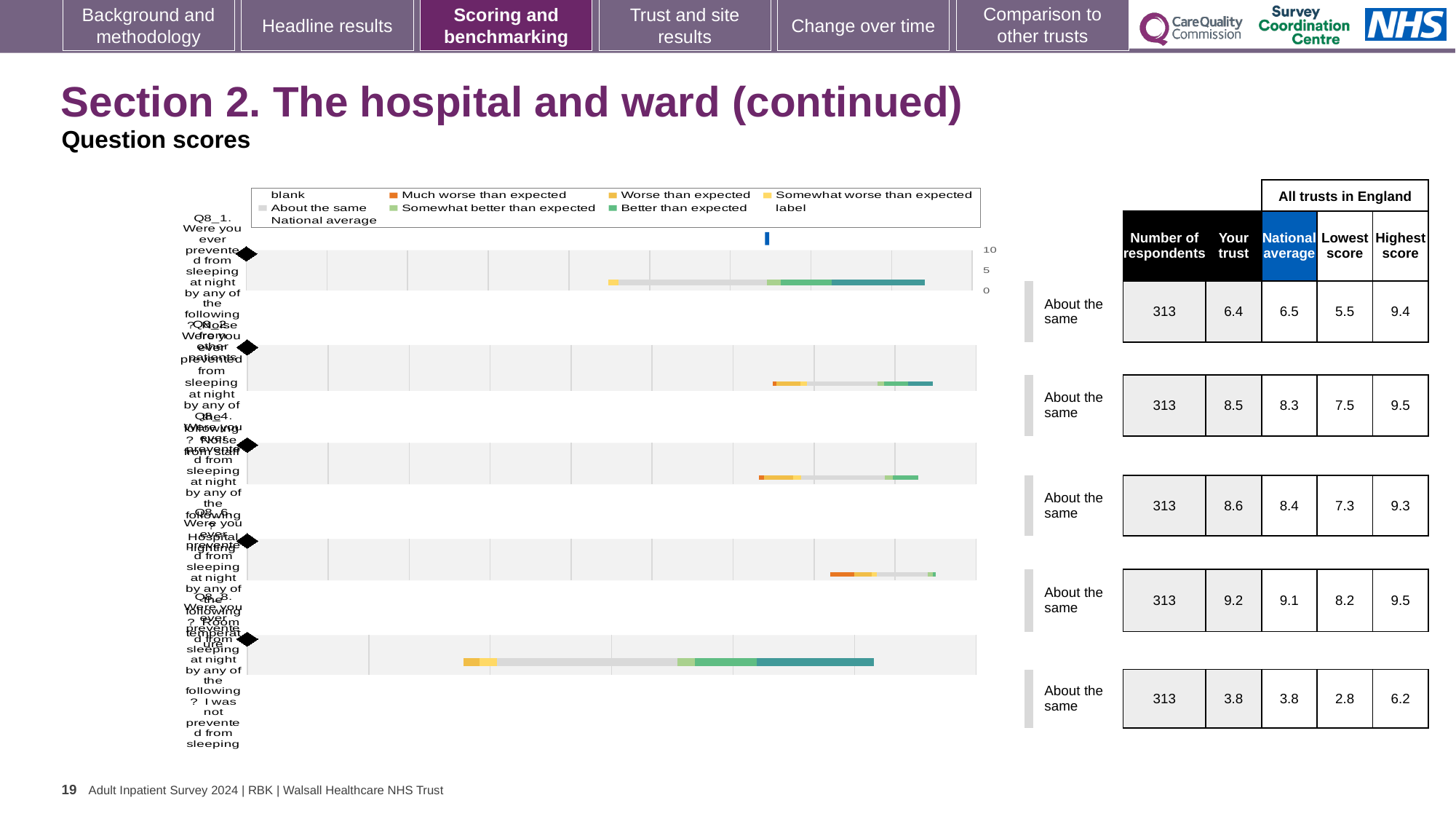
For the first question row, what is the difference between the highest score and the lowest score across all trusts in England? 3.9 What is the 'Your trust' score for the first (top) question row? 6.4 Which question row has the lowest 'Your trust' score? The fifth (bottom) row (3.8) How many respondents are listed for each question row? 313 What kind of chart is shown on the slide? Bar chart How many question rows (bars) are plotted in the chart? 5 What is the national average for the second question row? 8.3 Is the trust's value for the fifth (bottom) question row greater or less than 5? less What benchmark category is shown for every question row in the chart? About the same In the chart legend, what does the dark teal colour represent? Better than expected In the third question row, which is larger: the 'Your trust' score or the national average? Your trust (8.6) Which question row has the highest 'Your trust' score? The fourth row (9.2)